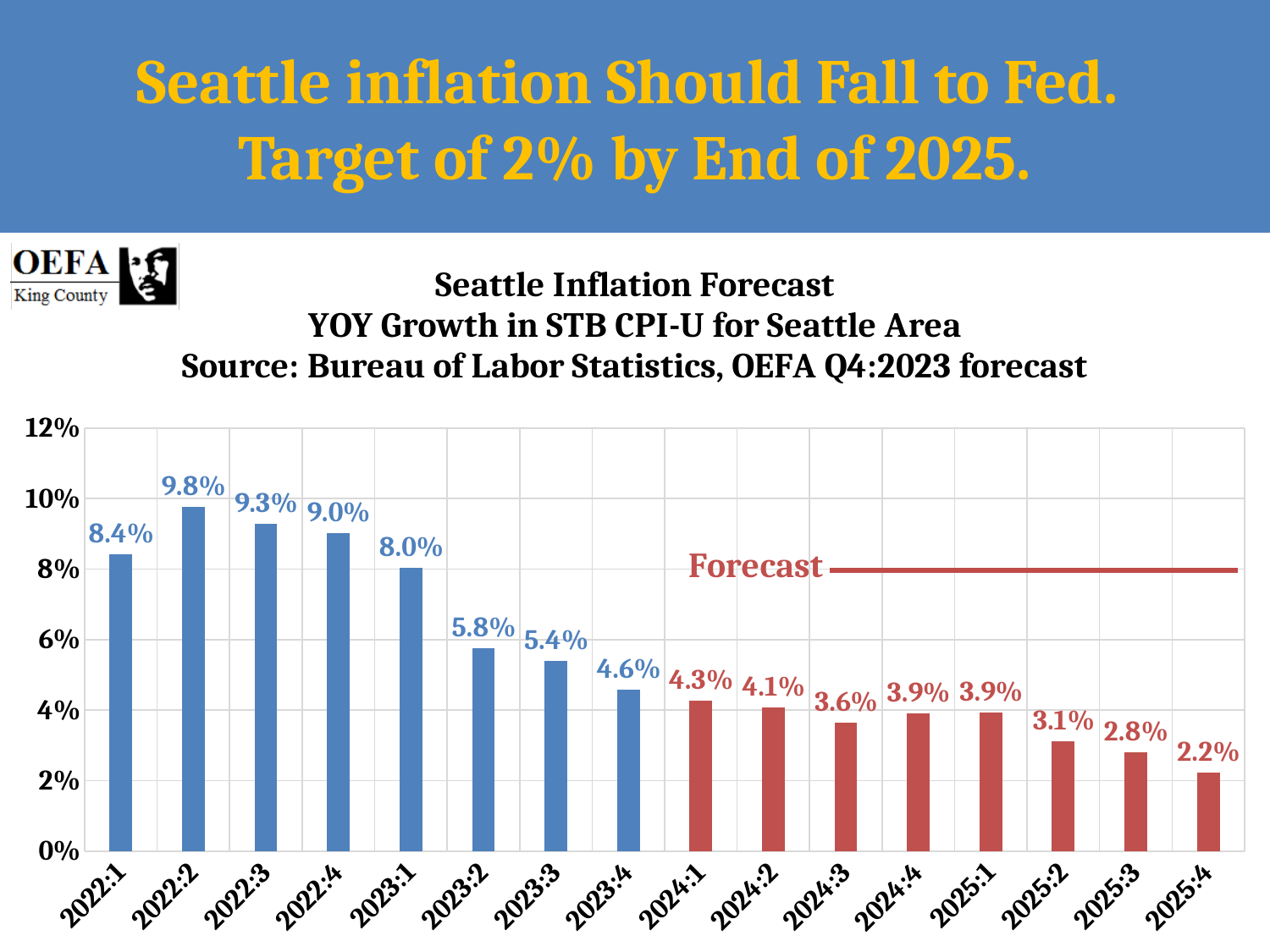
What kind of chart is this? bar chart Do the values generally rise or fall from 2022:2 to 2025:4? fall Which quarter has the highest value? 2022:2 What colour are the forecast bars? red What is the value for 2024:3? 3.6% How many quarters are shown on the x axis? 16 What is the value for 2025:4? 2.2% Is the value for 2023:2 greater or less than 6%? less What is the value for 2022:2? 9.8% What is the difference between the values for 2022:1 and 2023:1? 0.4% Which quarter has the lowest value? 2025:4 Which is larger, the value for 2023:4 or the value for 2024:1? 2023:4